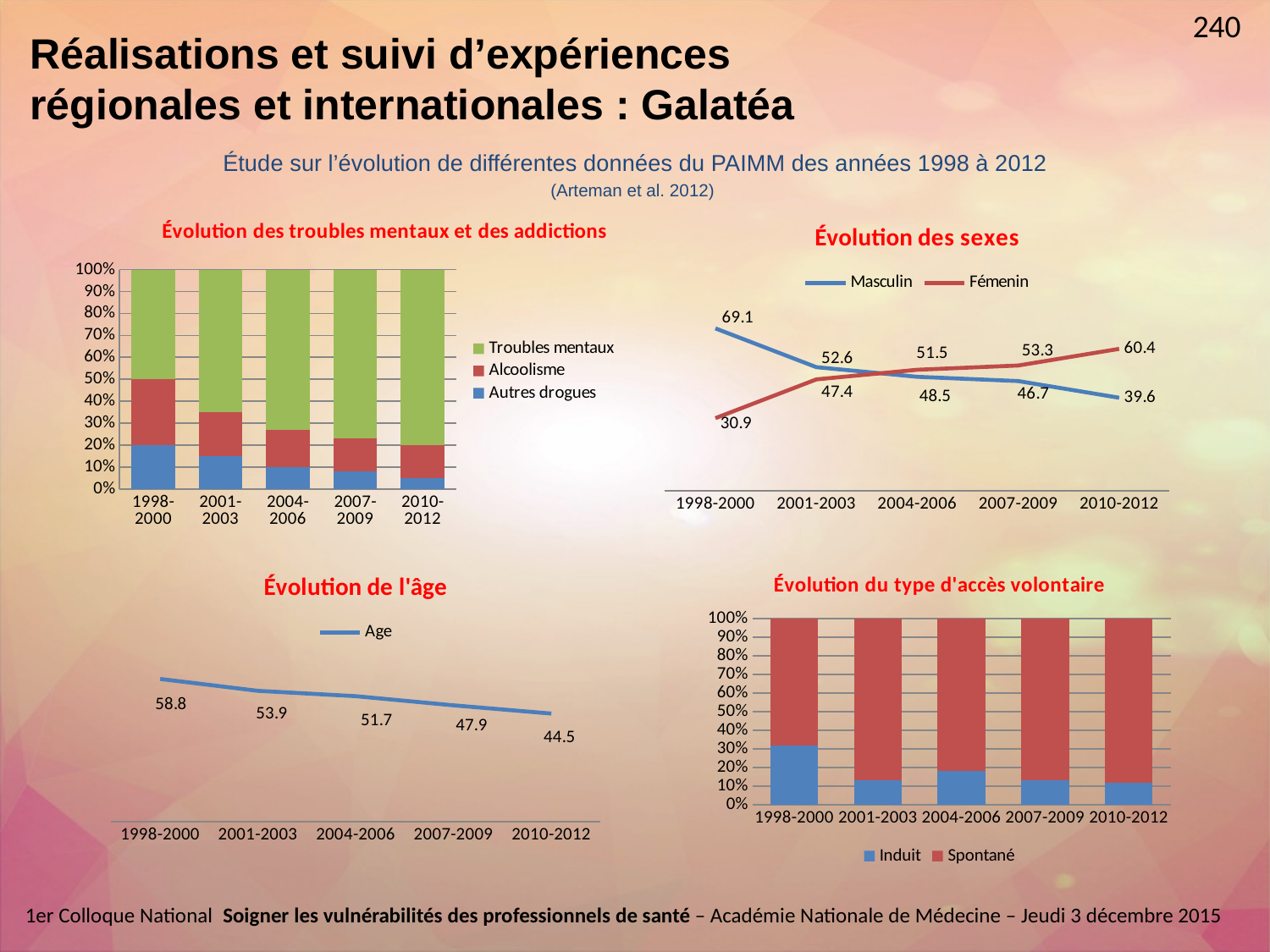
What kind of chart is 'Évolution du type d'accès volontaire'? bar chart In the 'Évolution des sexes' chart, in which period is the Fémenin value highest? 2010-2012 In the 'Évolution de l'âge' chart, what is the difference between the Age values for 1998-2000 and 2010-2012? 14.3 How many series does the legend of the 'Évolution des troubles mentaux et des addictions' chart list? 3 In the 'Évolution de l'âge' chart, do the Age values rise or fall from 1998-2000 to 2010-2012? fall How many periods are shown on the x axis of the 'Évolution des sexes' chart? 5 In the 'Évolution des sexes' chart, what is the difference between the Masculin and Fémenin values for 1998-2000? 38.2 In the 'Évolution du type d'accès volontaire' chart, is the Induit value for 1998-2000 greater or less than 20%? greater In the 'Évolution des sexes' chart, which is larger for 2007-2009, Masculin or Fémenin? Fémenin In the 'Évolution des sexes' chart, what is the Masculin value for 1998-2000? 69.1 In the 'Évolution de l'âge' chart, what is the Age value for 2004-2006? 51.7 In the 'Évolution des sexes' chart, what is the Fémenin value for 2010-2012? 60.4